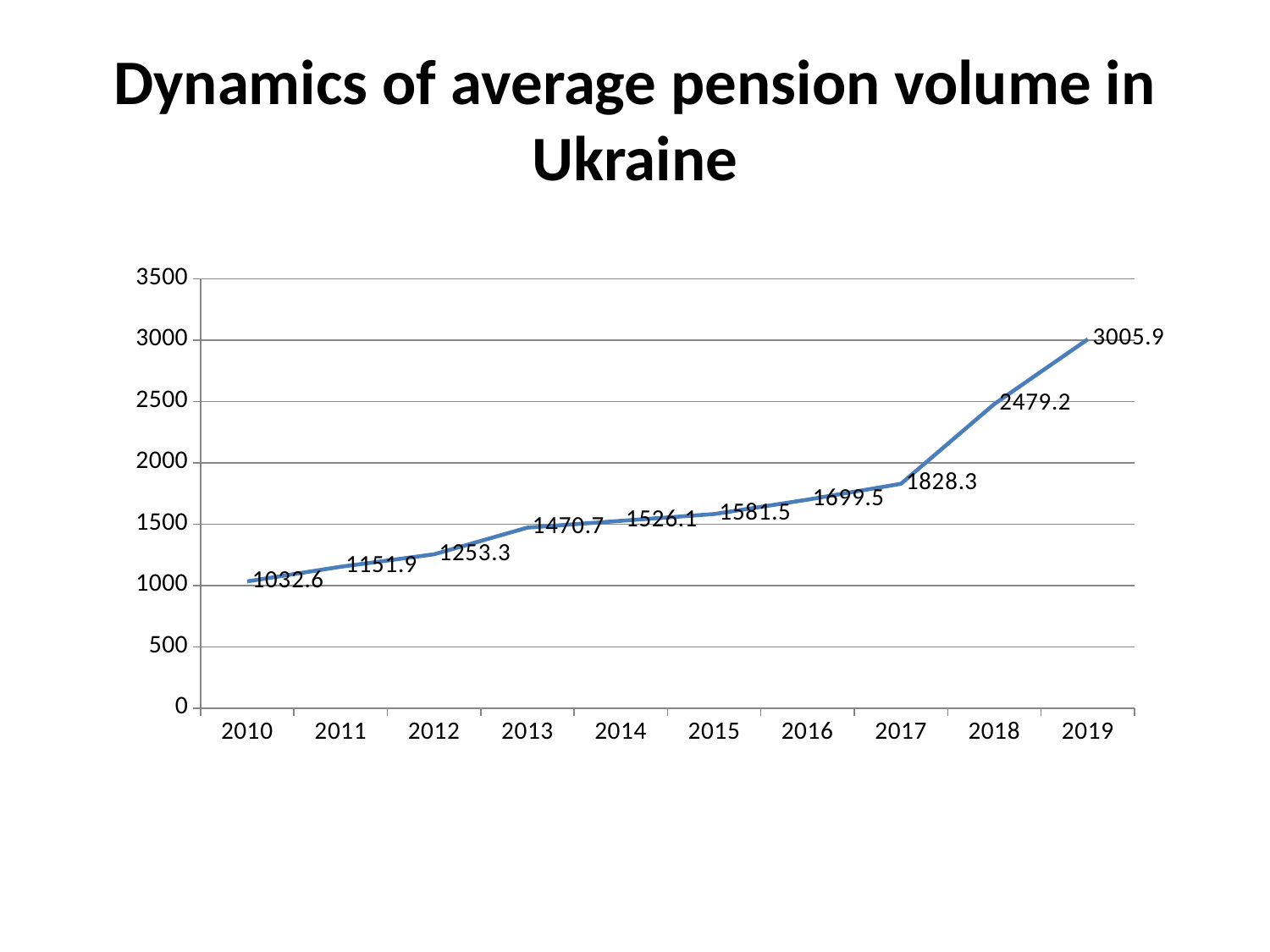
What is the average pension volume in 2010? 1032.6 What is the difference between the values for 2011 and 2010? 119.3 What is the value shown for 2017? 1828.3 How many years are plotted on the chart? 10 What kind of chart is shown on the slide? line chart Which year has the lowest average pension volume? 2010 What is the average pension volume in 2019? 3005.9 What is the difference between the values for 2019 and 2018? 526.7 Do the values rise or fall from 2010 to 2019? rise What is the value shown for 2013? 1470.7 Which is larger, the value for 2016 or the value for 2015? 2016 Which year has the highest average pension volume? 2019